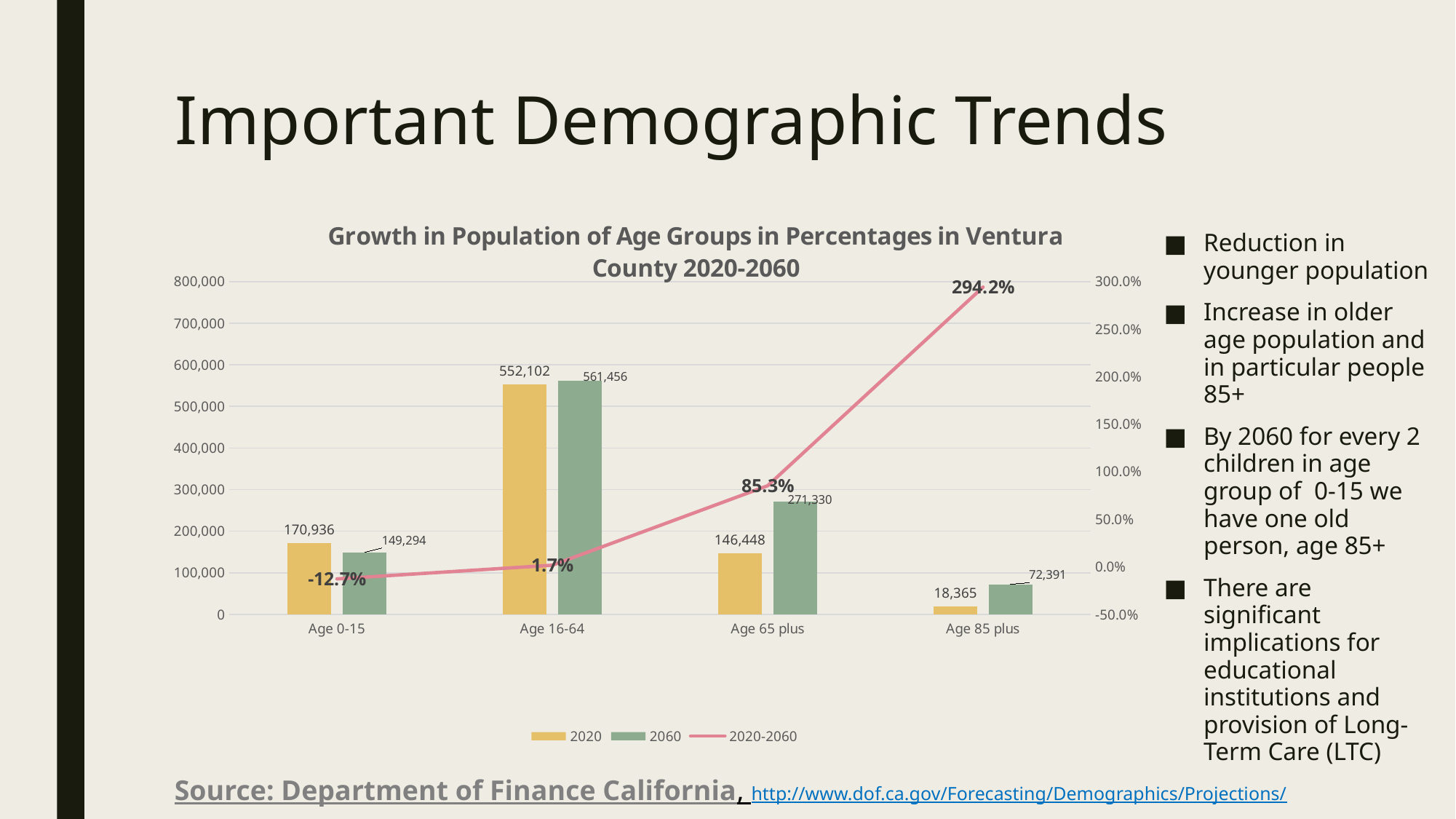
How many series does the legend list? 3 Which age group has the lowest 2020 population value? Age 85 plus What growth percentage does the 2020-2060 line show for Age 0-15? -12.7% What is the 2060 population value for Age 85 plus? 72,391 What is the title of the chart? Growth in Population of Age Groups in Percentages in Ventura County 2020-2060 What is the 2020 population value for Age 0-15? 170,936 What is the difference between the 2060 and 2020 population values for Age 65 plus? 124,882 Which age group has the highest 2060 population value? Age 16-64 Which is larger for Age 0-15, the 2020 value or the 2060 value? 2020 How many age groups are shown on the x axis? 4 What growth percentage does the 2020-2060 line show for Age 65 plus? 85.3% Does the 2020-2060 growth line rise or fall from Age 0-15 to Age 85 plus? rises